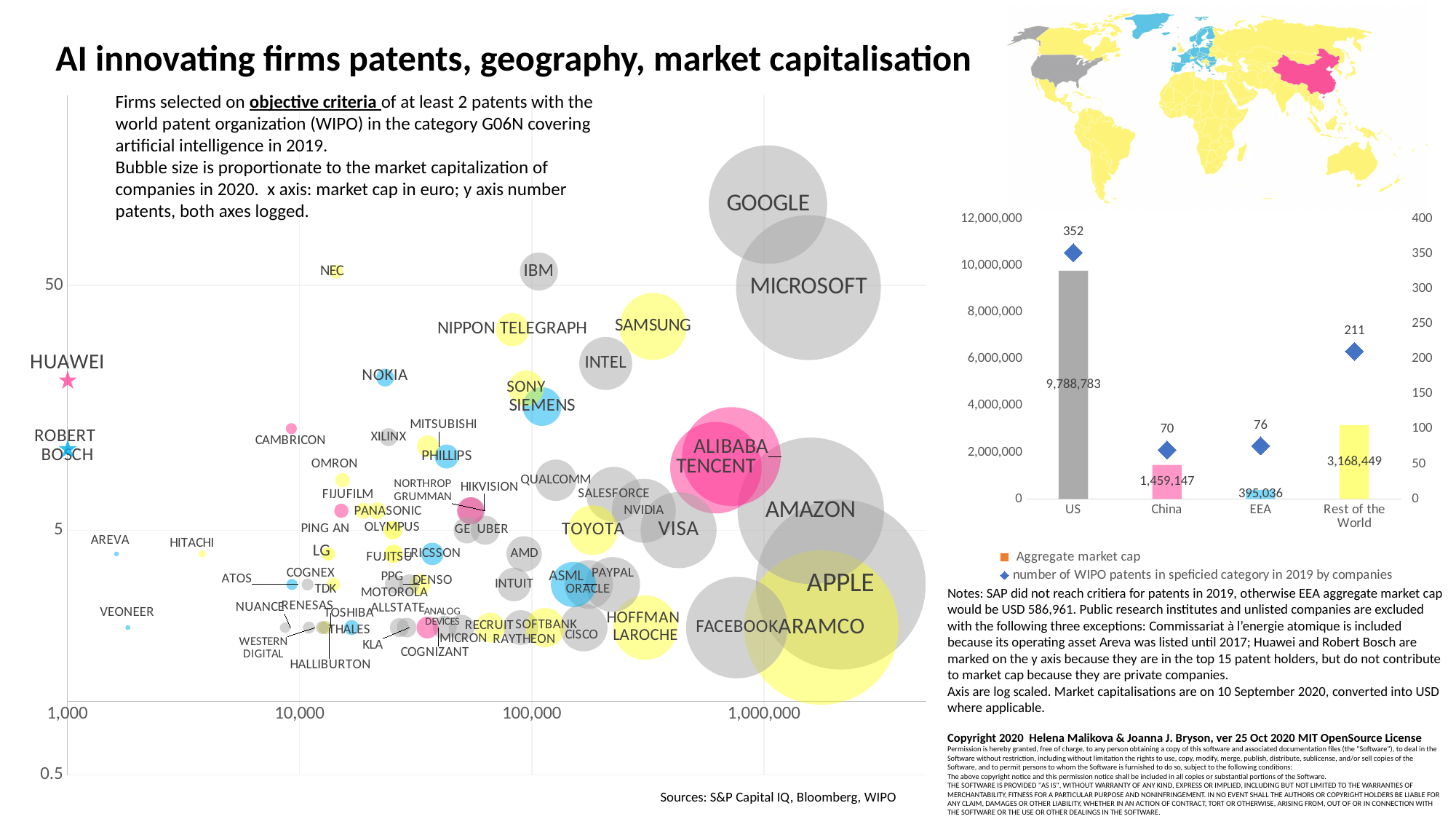
In the bar chart on the right, which has the larger aggregate market cap, China or Rest of the World? Rest of the World In the bar chart on the right, which region has the lowest aggregate market cap? EEA In the bar chart on the right, what is the aggregate market cap for China? 1,459,147 In the bar chart on the right, how many WIPO patents in the specified category in 2019 are shown for the US? 352 In the bar chart on the right, what is the difference in number of WIPO patents between EEA and China? 6 In the bar chart on the right, what is the aggregate market cap for the US? 9,788,783 In the bar chart on the right, how many WIPO patents are shown for Rest of the World? 211 In the bar chart on the right, how many series does the legend list? 2 In the bar chart on the right, how many regions are shown on the x axis? 4 In the bubble chart on the left, which two firms are marked with stars on the y axis because they are private companies? Huawei and Robert Bosch In the bar chart on the right, which region has the highest number of WIPO patents? US In the bar chart on the right, what is the difference in aggregate market cap between the US and Rest of the World? 6,620,334